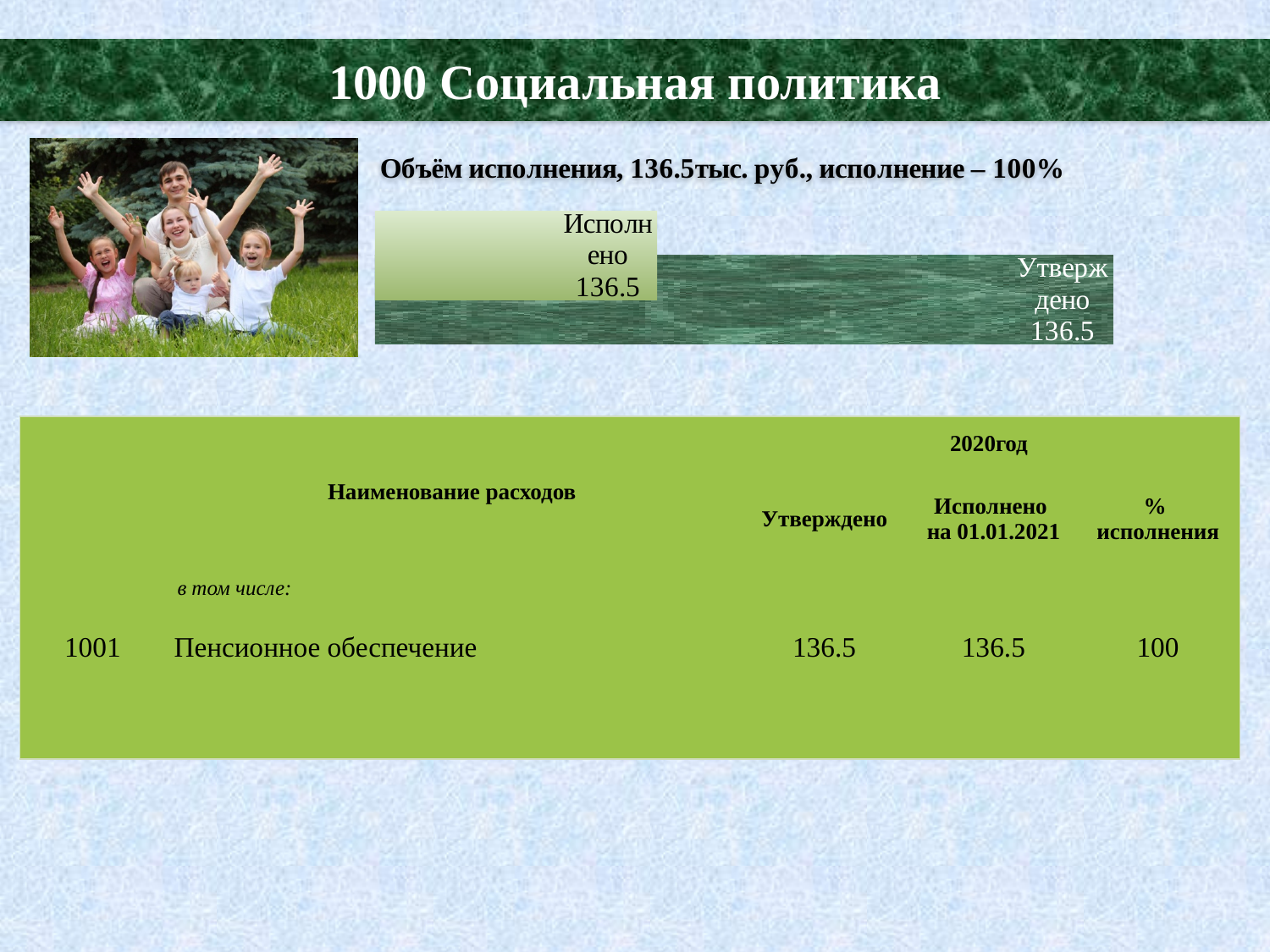
What is the value of the bar labelled Исполнено? 136.5 Are the values for Исполнено and Утверждено in the chart equal? yes What is the difference between the Утверждено and Исполнено values in the chart? 0 What is the value of the bar labelled Утверждено? 136.5 Is the value for Исполнено greater or less than 100? greater Which bar in the chart is drawn in light green? Исполнено How many bars does the chart show? 2 Which bar in the chart is drawn in dark green? Утверждено What kind of chart is shown on the slide? bar chart